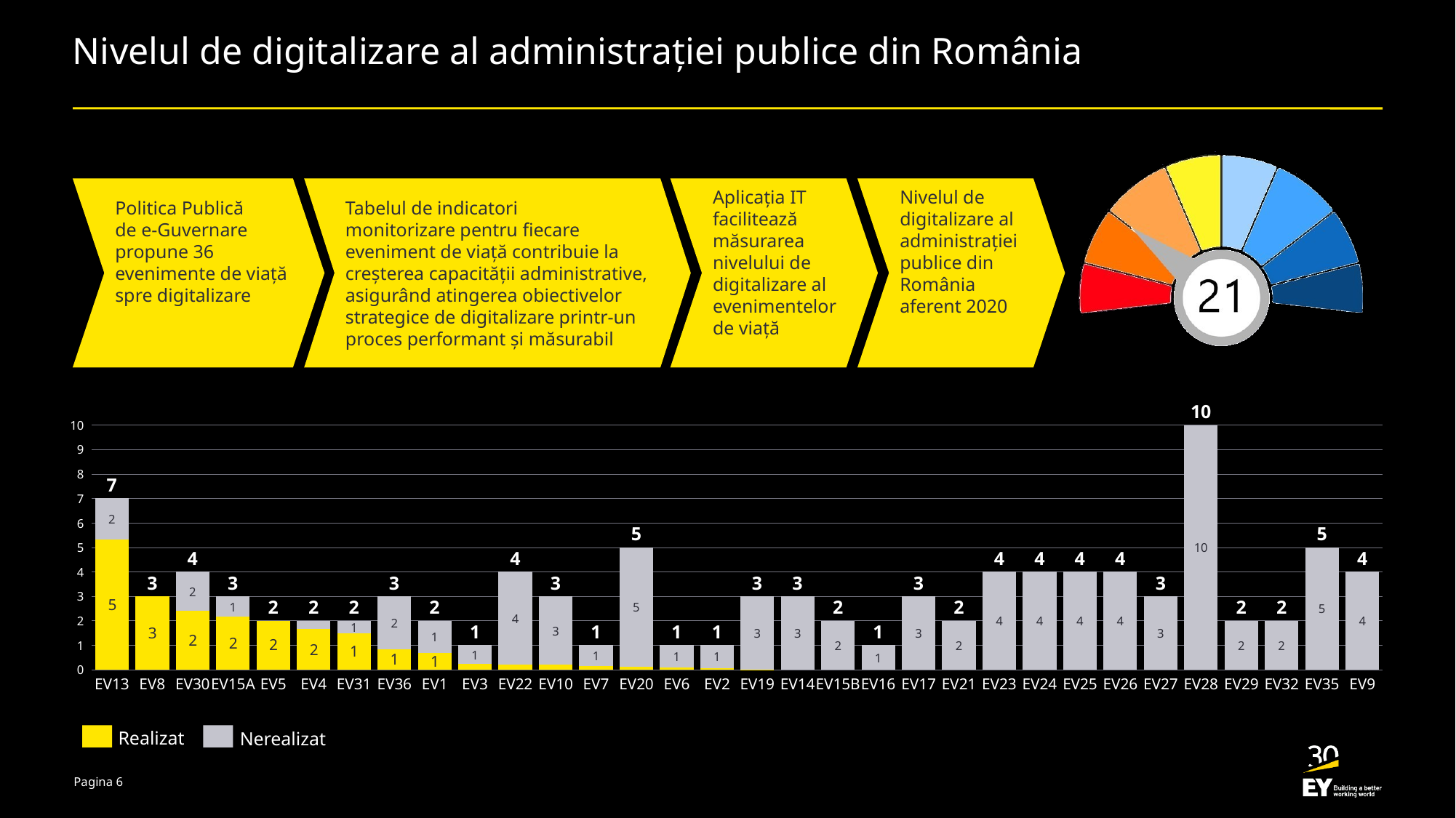
How many categories are shown on the x axis of the bar chart? 32 What kind of chart is shown at the bottom of the slide? Stacked bar chart What is the total value shown above the bar for EV13? 7 Is the total for EV28 greater or less than 8? greater What is the Nerealizat value for EV28? 10 What is the difference between the total for EV28 and the total for EV13? 3 How many series does the legend of the bar chart list? 2 What is the total value shown above the bar for EV35? 5 What are the two legend entries of the bar chart? Realizat, Nerealizat Which category has the highest total in the bar chart? EV28 What is the Realizat value for EV13? 5 Which has the larger total, EV20 or EV10? EV20